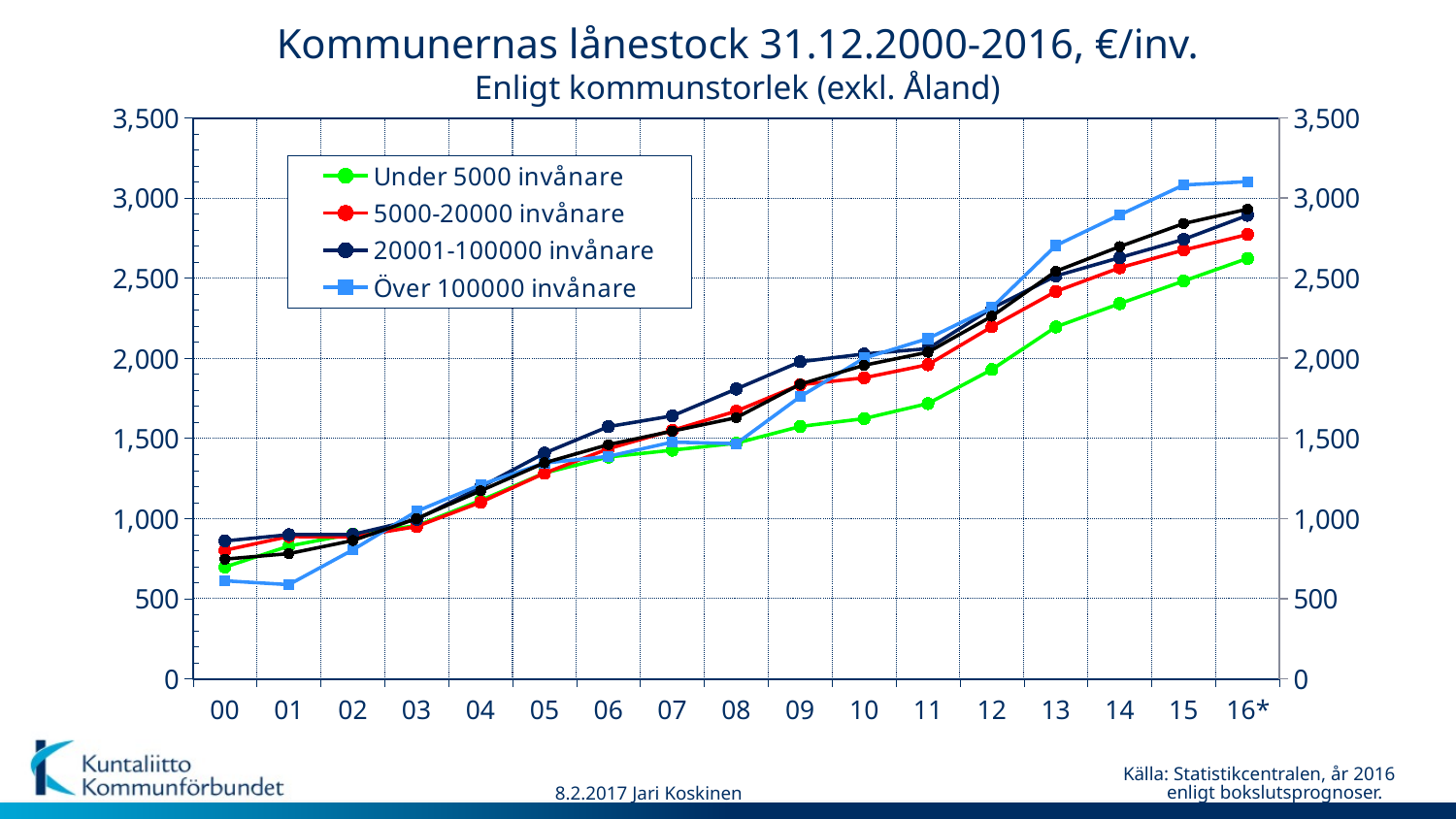
Is the value for Över 100000 invånare in 01 greater or less than 1,000? less How many years (points) are plotted along the x axis? 17 Is the value for Under 5000 invånare in 00 greater or less than 1,000? less Which series has the lowest value in 00? Över 100000 invånare Is the value for Över 100000 invånare in 16* greater or less than 3,000? greater In 12, which is larger: Under 5000 invånare or 5000-20000 invånare? 5000-20000 invånare Which series has the highest value in 16*? Över 100000 invånare What kind of chart is shown on the slide? line chart Which series has the lowest value in 16*? Under 5000 invånare Does the Under 5000 invånare series rise or fall from 00 to 16*? rise What is the main title of the chart? Kommunernas lånestock 31.12.2000-2016, €/inv. How many series does the legend list? 4